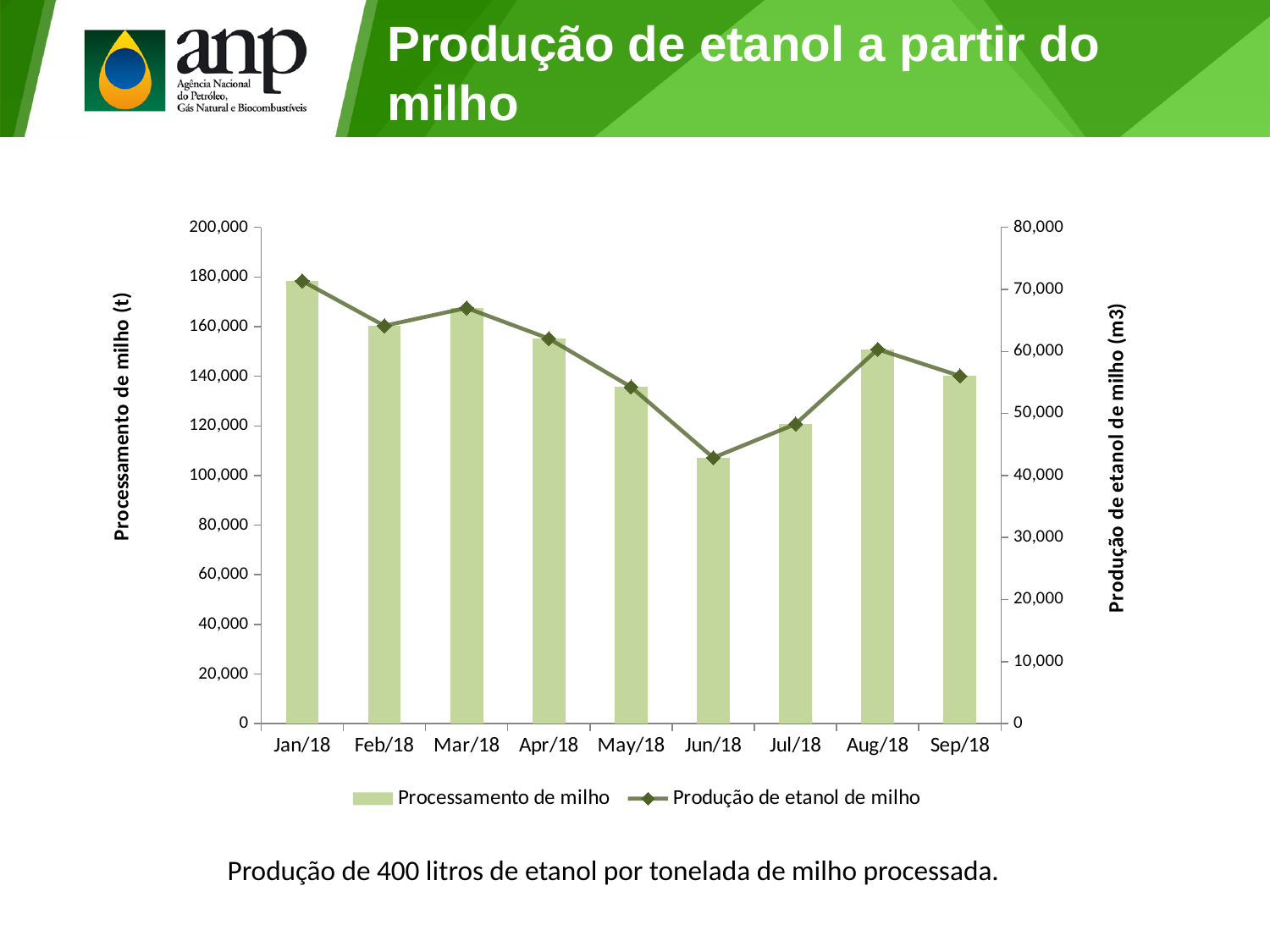
Does the Produção de etanol de milho line rise or fall from Mar/18 to Jun/18? Fall Which month has the lowest bar for Processamento de milho? Jun/18 Which month has the larger Processamento de milho bar, Jan/18 or Feb/18? Jan/18 What is the title of the left vertical axis? Processamento de milho (t) What is the title of the right vertical axis? Produção de etanol de milho (m3) How many series does the chart legend list? 2 How many months are shown on the x axis of the chart? 9 Is the Processamento de milho bar for Jan/18 greater or less than 160,000? greater Which month has the highest bar for Processamento de milho? Jan/18 Is the Processamento de milho bar for Jun/18 greater or less than 120,000? less Is the Processamento de milho bar for Aug/18 greater or less than 140,000? greater What kind of chart is shown on the slide? Combined bar and line chart